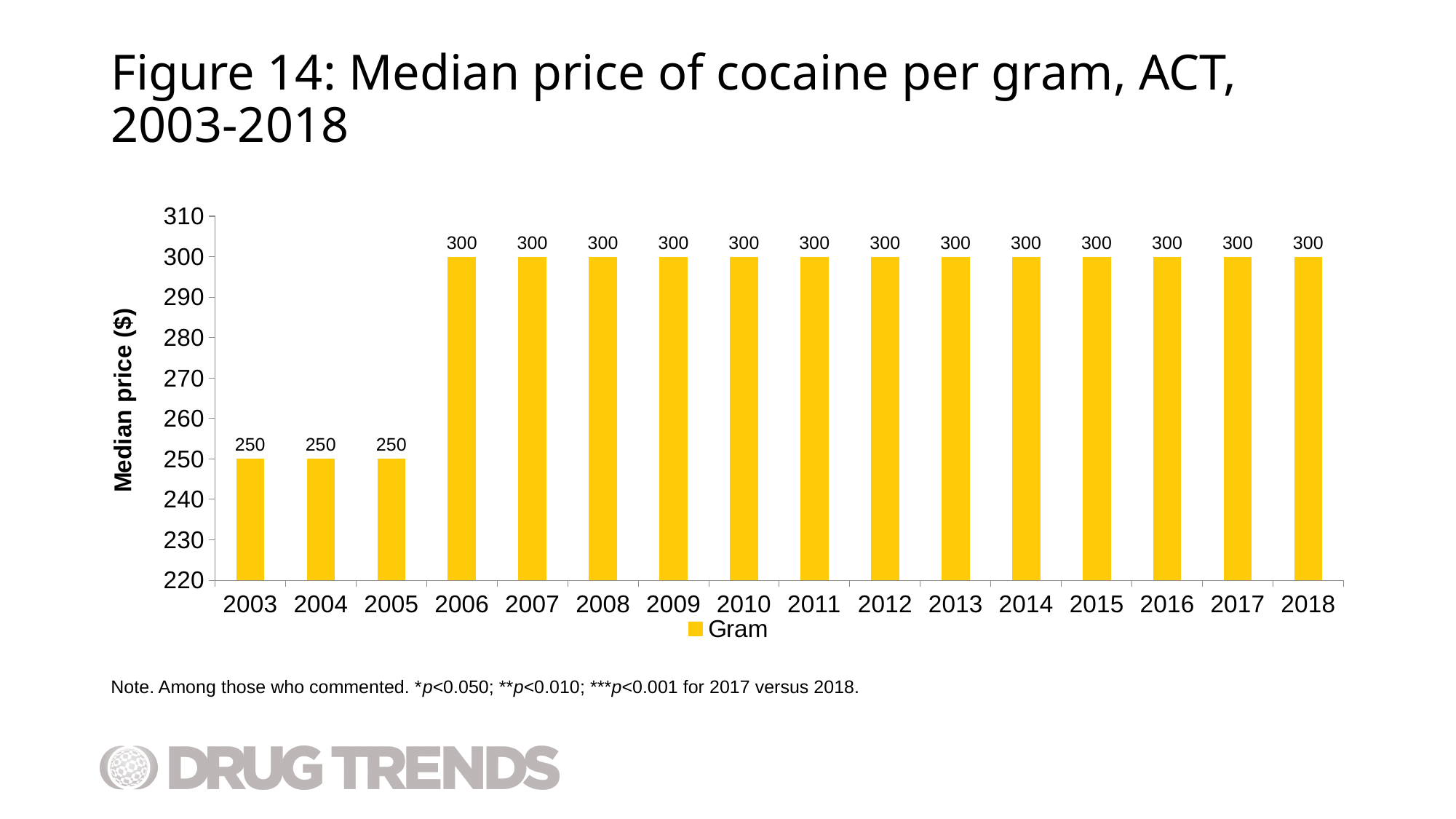
What kind of chart is shown on the slide? Bar chart Which is larger, the median price in 2004 or the median price in 2007? 2007 What is the median price of cocaine per gram in 2010? 300 Does the median price rise or fall from 2005 to 2006? Rise What is the difference between the median price in 2006 and the median price in 2005? 50 How many years are shown on the x axis? 16 Is the value for 2012 greater or less than 290? greater What is the median price of cocaine per gram in 2003? 250 Is the value for 2005 greater or less than 260? less What is the median price of cocaine per gram in 2018? 300 What is the label of the y axis? Median price ($) How many series does the legend list? 1